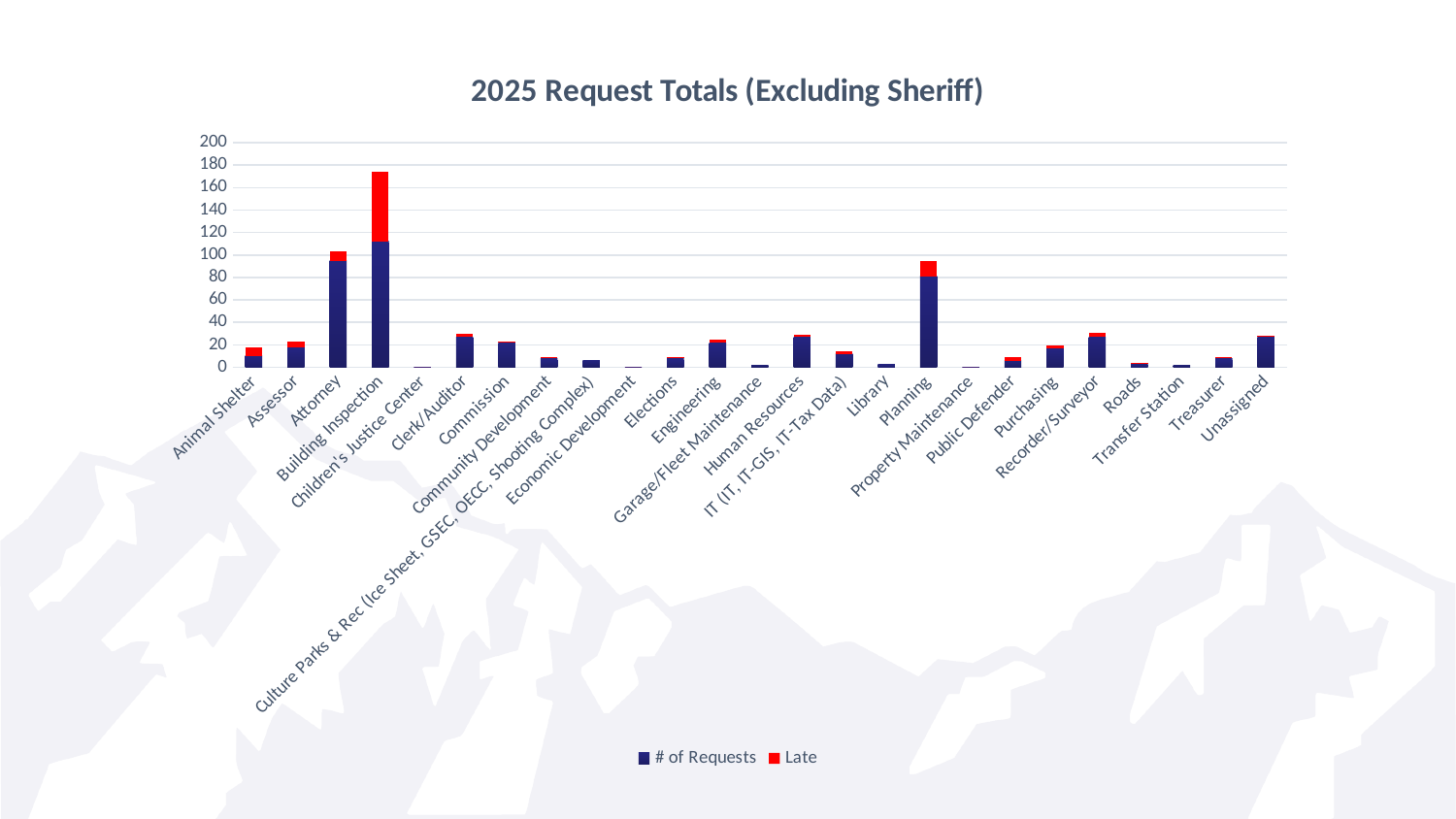
Is the total bar height for Building Inspection greater or less than 160? greater How many series does the legend list? 2 Is the total bar height for Planning greater or less than 100? less Which has the taller bar, Unassigned or Roads? Unassigned Is the total bar height for Clerk/Auditor greater or less than 40? less Which category has the tallest bar? Building Inspection Which series is shown in red in the legend? Late What kind of chart is shown on the slide? Stacked bar chart What is the title of the chart? 2025 Request Totals (Excluding Sheriff) How many categories are shown along the x axis? 25 Which has the taller bar, Building Inspection or Attorney? Building Inspection